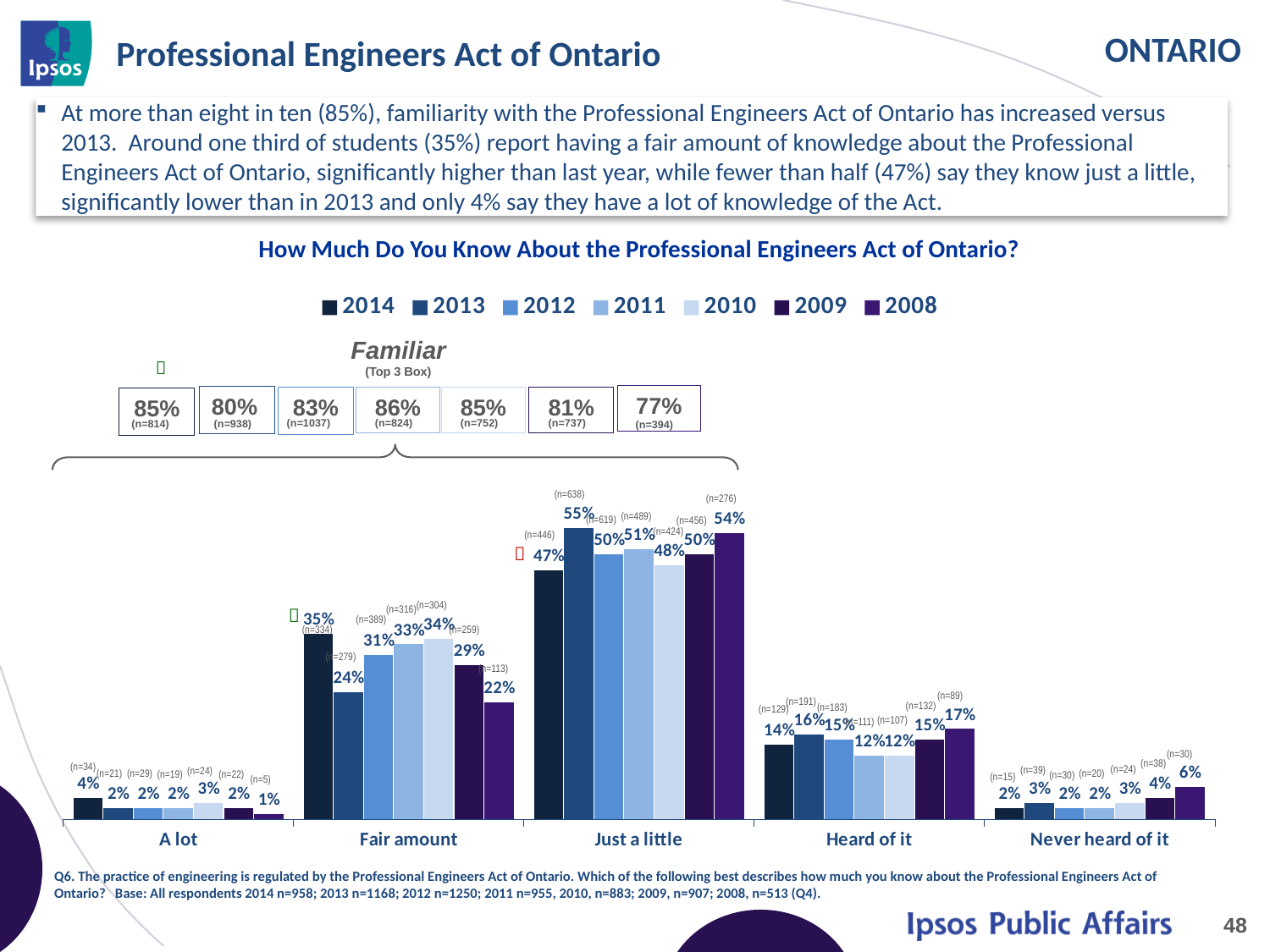
What is the difference between the 2014 and 2013 values for 'Fair amount'? 11 percentage points Which is larger for 'Just a little': the 2014 value or the 2008 value? 2008 What is the 2013 value for 'Just a little'? 55% Which year has the lowest value in the 'Fair amount' category? 2008 How many response categories are shown on the x axis? 5 What is the 2008 value for 'Never heard of it'? 6% How many years (series) does the legend list? 7 What percentage of 2014 respondents said they know a 'Fair amount' about the Professional Engineers Act of Ontario? 35% What is the 'Familiar (Top 3 Box)' percentage shown for 2014? 85% What is the 2014 value for 'Heard of it'? 14% What type of chart is shown on the slide? Bar chart Which category has the highest value for the 2014 series? Just a little